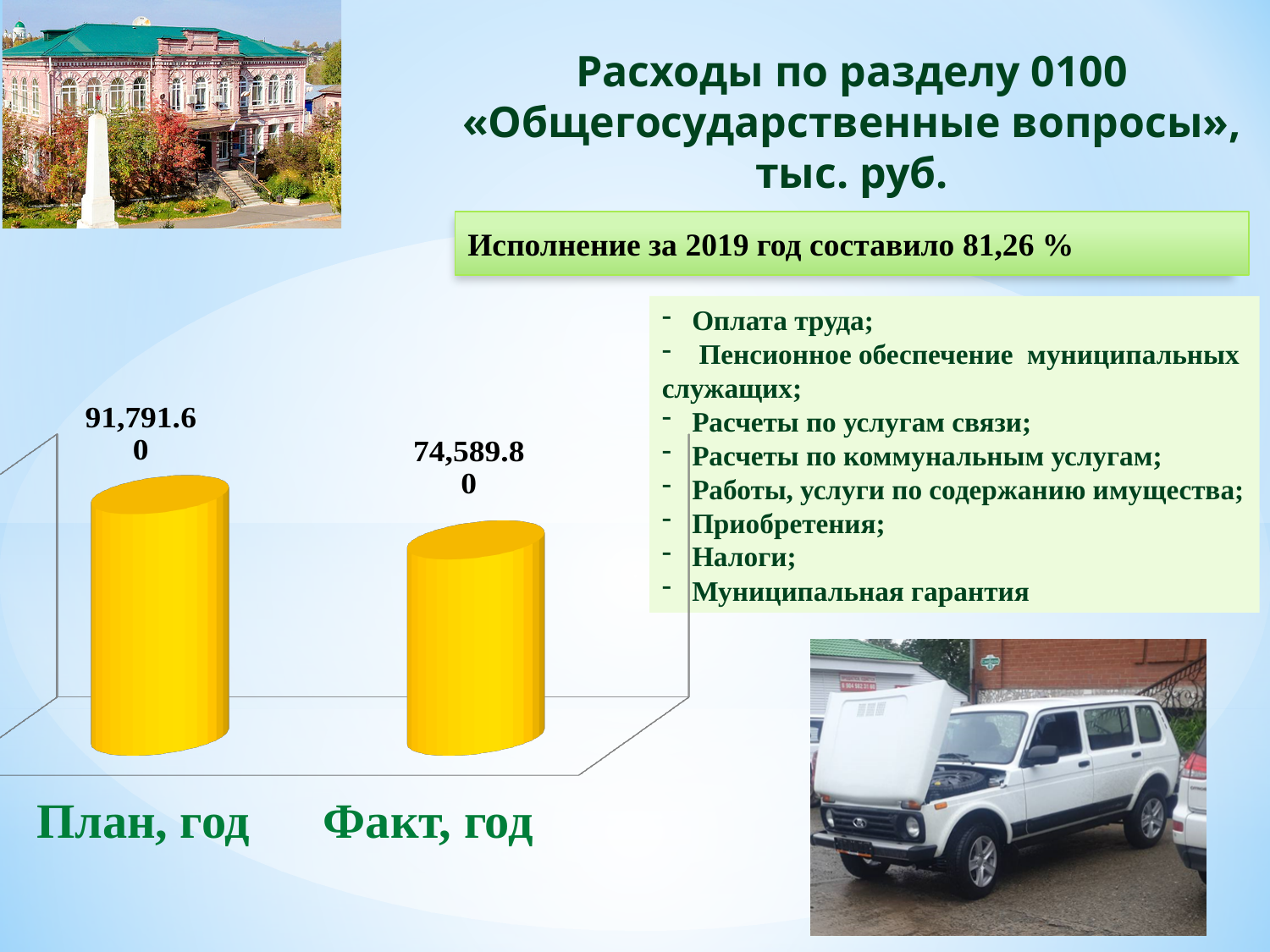
What unit of measurement is stated in the chart's title? тыс. руб. What colour are the bars on the chart? yellow How many categories are shown on the chart? 2 What is the value for «План, год» on the chart? 91,791.60 What is the value for «Факт, год» on the chart? 74,589.80 What is the difference between the values for «План, год» and «Факт, год»? 17,201.80 What kind of chart is shown on the slide? bar chart Which category has the lower value on the chart? Факт, год Is the value for «План, год» larger or smaller than the value for «Факт, год»? larger Do the values rise or fall from «План, год» to «Факт, год»? fall Which category has the higher value on the chart? План, год